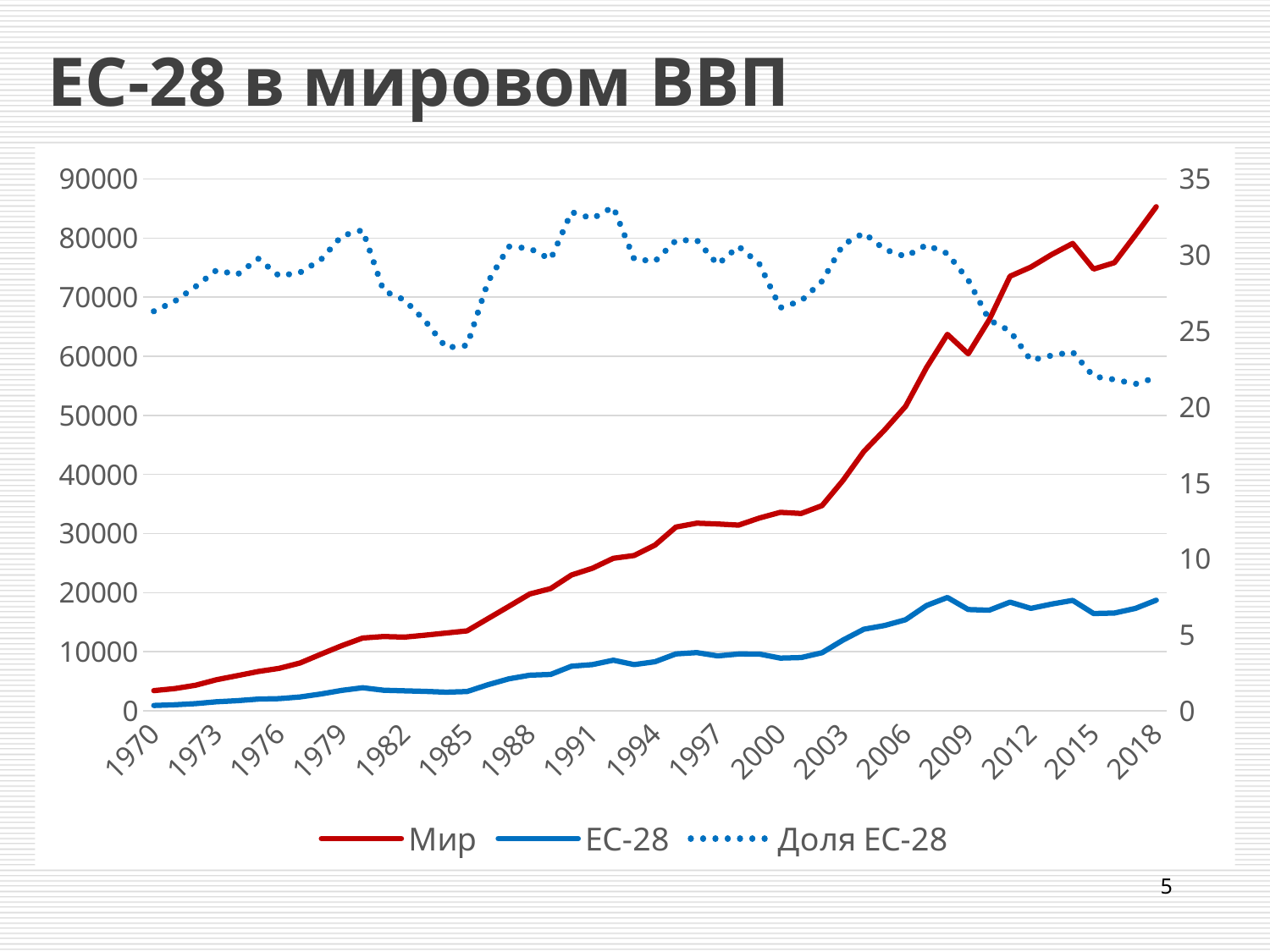
Is the value for Доля ЕС-28 in 1991 greater or less than 30 on the right axis? greater What is the title of the chart on the slide? ЕС-28 в мировом ВВП Is the value for Мир in 2018 greater or less than 80000? greater How many series does the legend list? 3 Is the value for ЕС-28 in 2018 greater or less than 20000? less Does the Мир series generally rise or fall from 1970 to 2018? rise Which series is drawn with a dotted line? Доля ЕС-28 What kind of chart is shown on the slide? line chart Which series has the larger value in 2018, Мир or ЕС-28? Мир